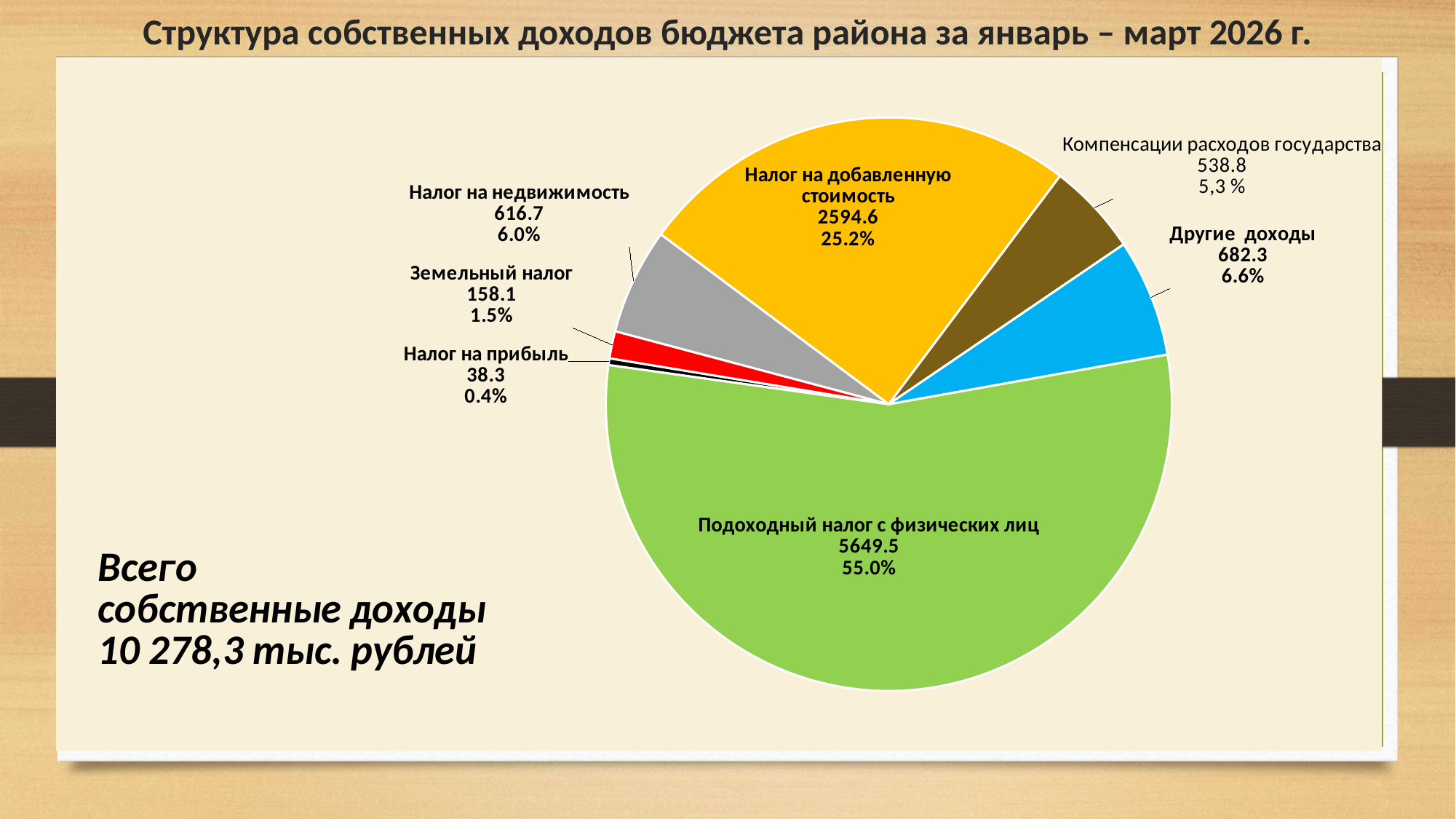
What is the difference between the values for Подоходный налог с физических лиц and Налог на добавленную стоимость? 3054.9 What is the value shown for Налог на недвижимость? 616.7 What kind of chart is shown on the slide? pie chart Which category has the largest slice of the pie? Подоходный налог с физических лиц How many slices does the pie chart have? 7 What share of the pie does Налог на прибыль represent? 0.4% What share of the pie does Налог на добавленную стоимость represent? 25.2% Which category has the smallest slice of the pie? Налог на прибыль What is the value shown for Подоходный налог с физических лиц? 5649.5 What colour is the slice for Земельный налог? red Which is larger, the value for Другие доходы or the value for Налог на недвижимость? Другие доходы What is the value shown for Компенсации расходов государства? 538.8